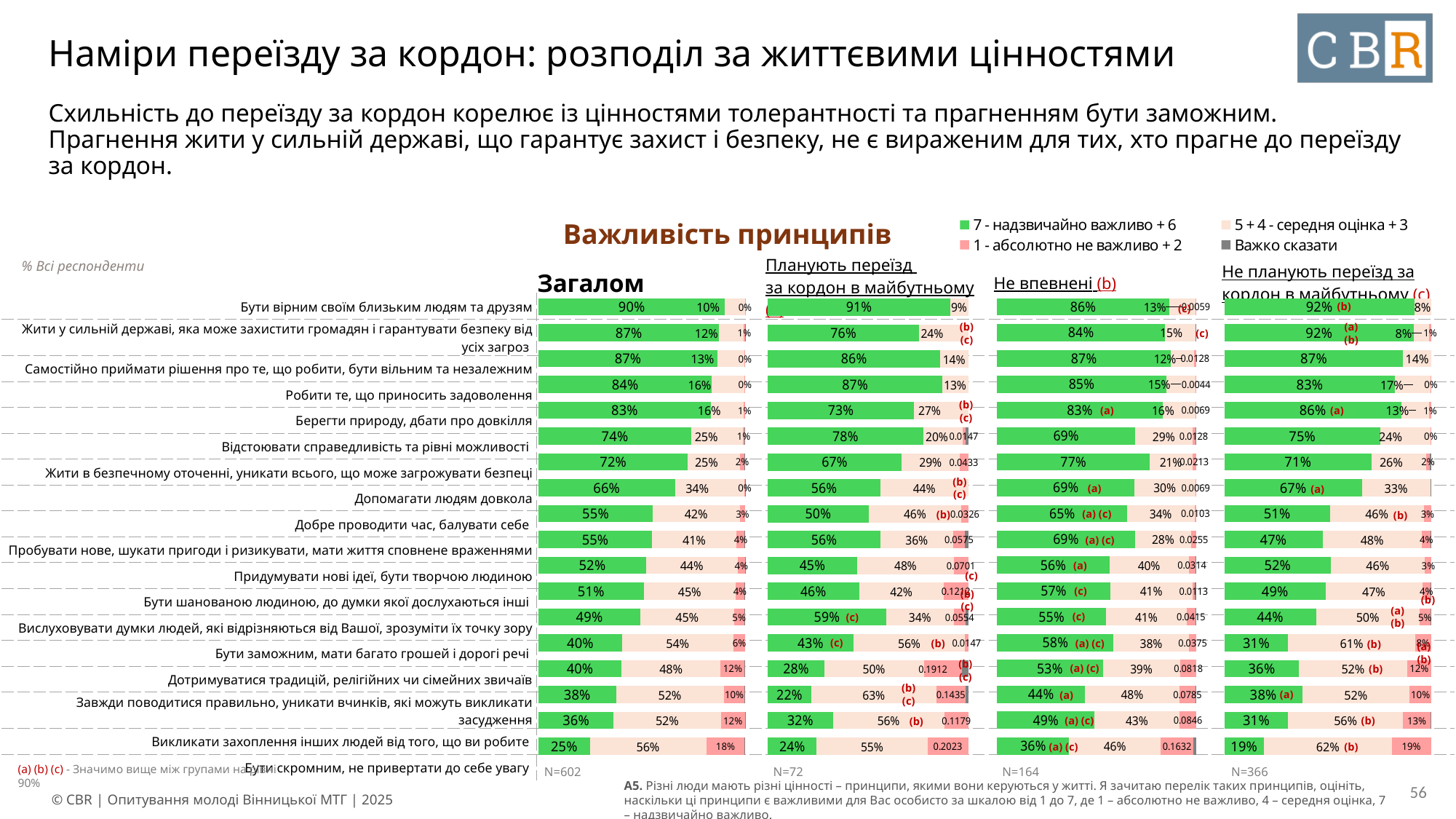
On the 'Загалом' chart, what is the value of the '7 - надзвичайно важливо + 6' segment for 'Бути вірним своїм близьким людям та друзям'? 90% On the 'Загалом' chart, what is the '1 - абсолютно не важливо + 2' value for 'Бути скромним, не привертати до себе уваги'? 18% On the 'Планують переїзд за кордон в майбутньому' chart, what is the '7 - надзвичайно важливо + 6' value for 'Жити у сильній державі, яка може захистити громадян і гарантувати безпеку від усіх загроз'? 76% How many series does the legend list for the charts on this slide? 4 For 'Бути заможним, мати багато грошей і дорогі речі', which chart shows a larger '7 - надзвичайно важливо + 6' value: 'Не впевнені' or 'Не планують переїзд за кордон в майбутньому'? Не впевнені How many principles (categories) are shown on the 'Загалом' chart? 18 On the 'Не планують переїзд за кордон в майбутньому' chart, what is the '7 - надзвичайно важливо + 6' value for 'Бути заможним, мати багато грошей і дорогі речі'? 31% On the 'Загалом' chart, which principle has the highest '7 - надзвичайно важливо + 6' value? Бути вірним своїм близьким людям та друзям On the 'Загалом' chart, which principle has the lowest '7 - надзвичайно важливо + 6' value? Бути скромним, не привертати до себе увагу On the 'Загалом' chart, what is the difference between the '7 - надзвичайно важливо + 6' values for 'Бути вірним своїм близьким людям та друзям' and 'Бути скромним, не привертати до себе уваги'? 65 percentage points What kind of chart is used for the 'Загалом' data? Stacked bar chart What is the sample size (N) shown under the 'Планують переїзд за кордон в майбутньому' chart? N=72